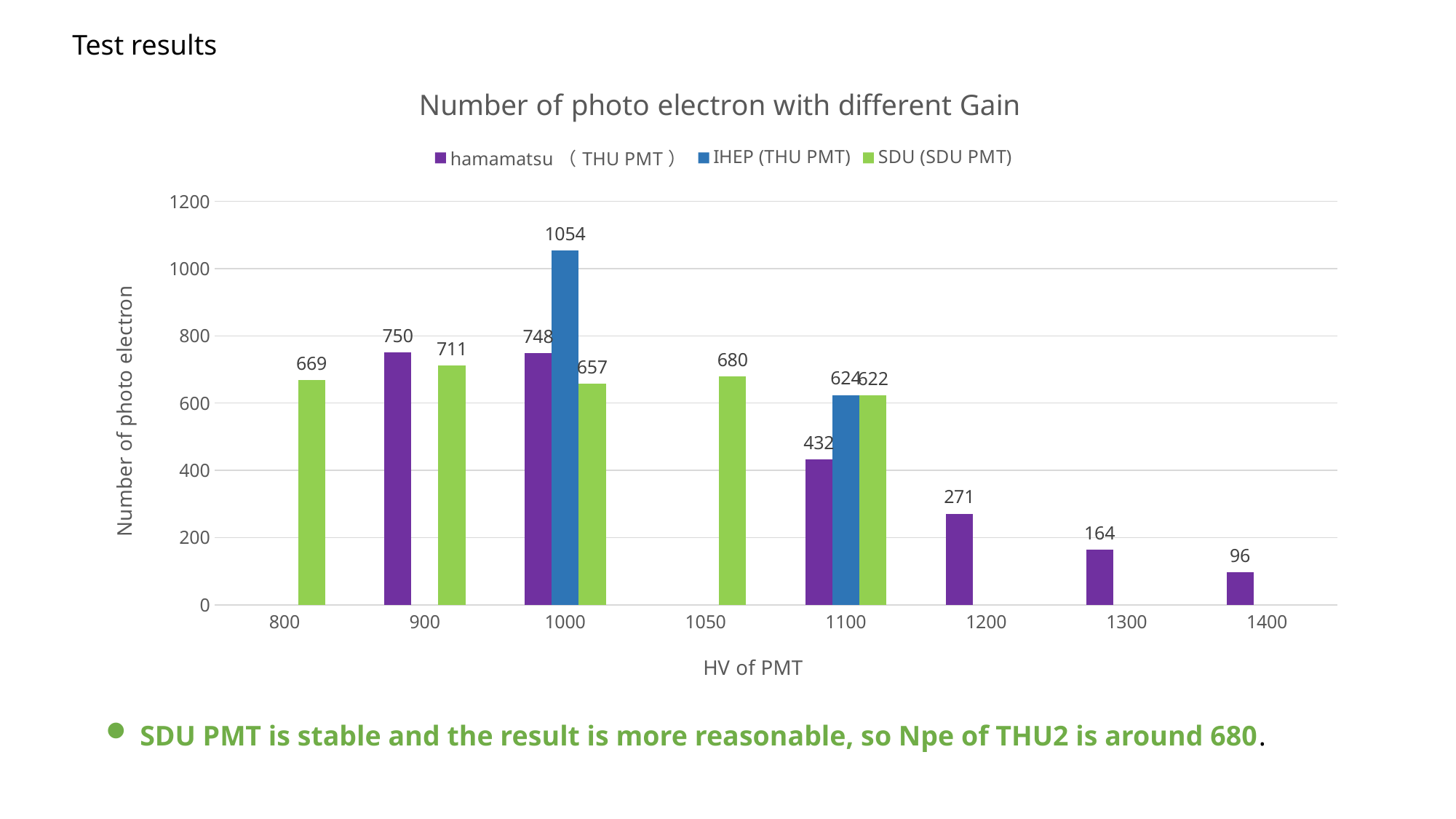
Does the hamamatsu (THU PMT) series rise or fall from HV 1100 to HV 1400? fall At HV 1100, which series has the larger value: hamamatsu (THU PMT) or IHEP (THU PMT)? IHEP (THU PMT) What is the value for SDU (SDU PMT) at HV 1050? 680 What is the difference between the IHEP (THU PMT) and SDU (SDU PMT) values at HV 1000? 397 At which HV does the SDU (SDU PMT) series have its lowest value? 1100 How many HV categories are shown on the x axis? 8 At which HV does the hamamatsu (THU PMT) series reach its highest value? 900 What is the value for IHEP (THU PMT) at HV 1000? 1054 How many series does the legend list? 3 What is the value for hamamatsu (THU PMT) at HV 1400? 96 What type of chart is shown on the slide? bar chart What is the title of the chart? Number of photo electron with different Gain